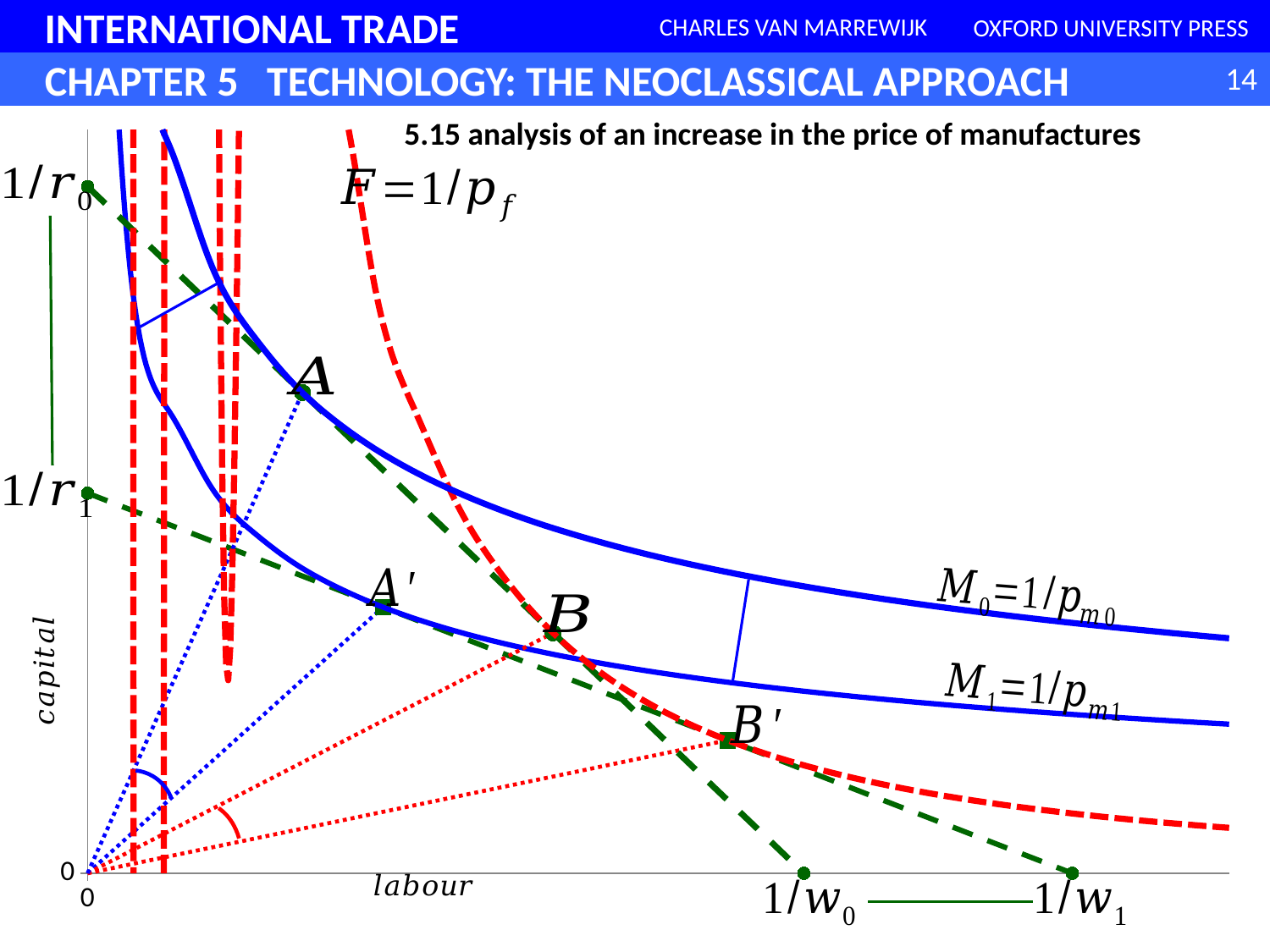
How many labelled points (A, A', B, B') are marked on the chart? 4 Which labelled point lies lowest on the chart, A, A', B or B'? B' Which labelled point lies highest on the chart, A, A', B or B'? A What kind of chart is shown on the slide? line chart What are the labels of the horizontal and vertical axes of the chart? labour (horizontal) and capital (vertical) On the capital axis, which intercept is higher, 1/r0 or 1/r1? 1/r0 Which of the two blue curves lies higher on the chart, M0 = 1/pm0 or M1 = 1/pm1? M0 = 1/pm0 What is the title of the chart on the slide? 5.15 analysis of an increase in the price of manufactures On the labour axis, which intercept is further to the right, 1/w0 or 1/w1? 1/w1